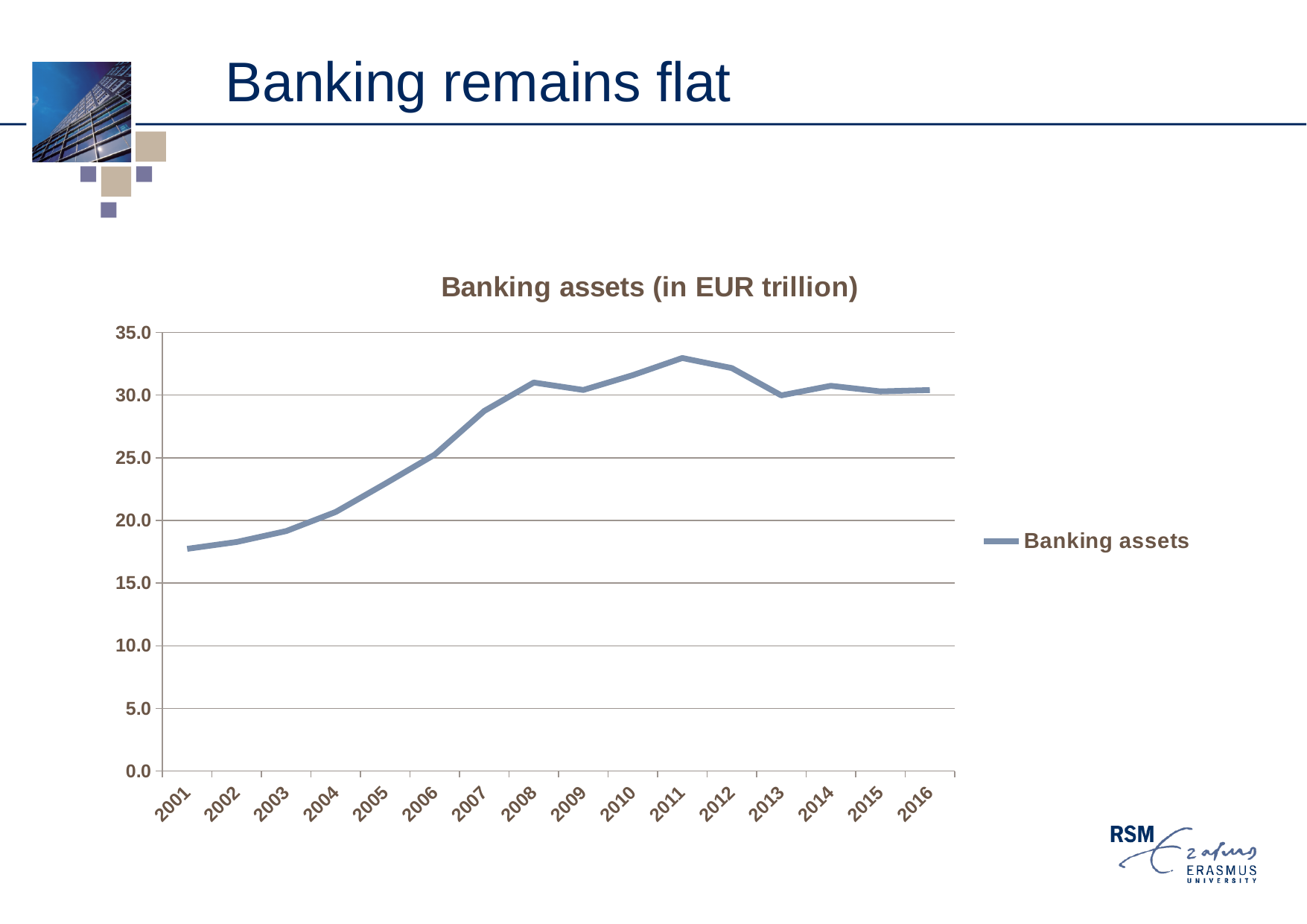
Is the value for 2007 greater or less than 25.0? greater How many series does the legend list? 1 What is the title of the chart? Banking assets (in EUR trillion) In which year are banking assets highest? 2011 Do banking assets rise or fall from 2001 to 2008? rise What kind of chart is shown on the slide? Line chart Is the value for 2001 greater or less than 20.0? less Is the value for 2003 greater or less than 20.0? less Which year has larger banking assets, 2011 or 2013? 2011 In which year are banking assets lowest? 2001 How many years are plotted on the x axis? 16